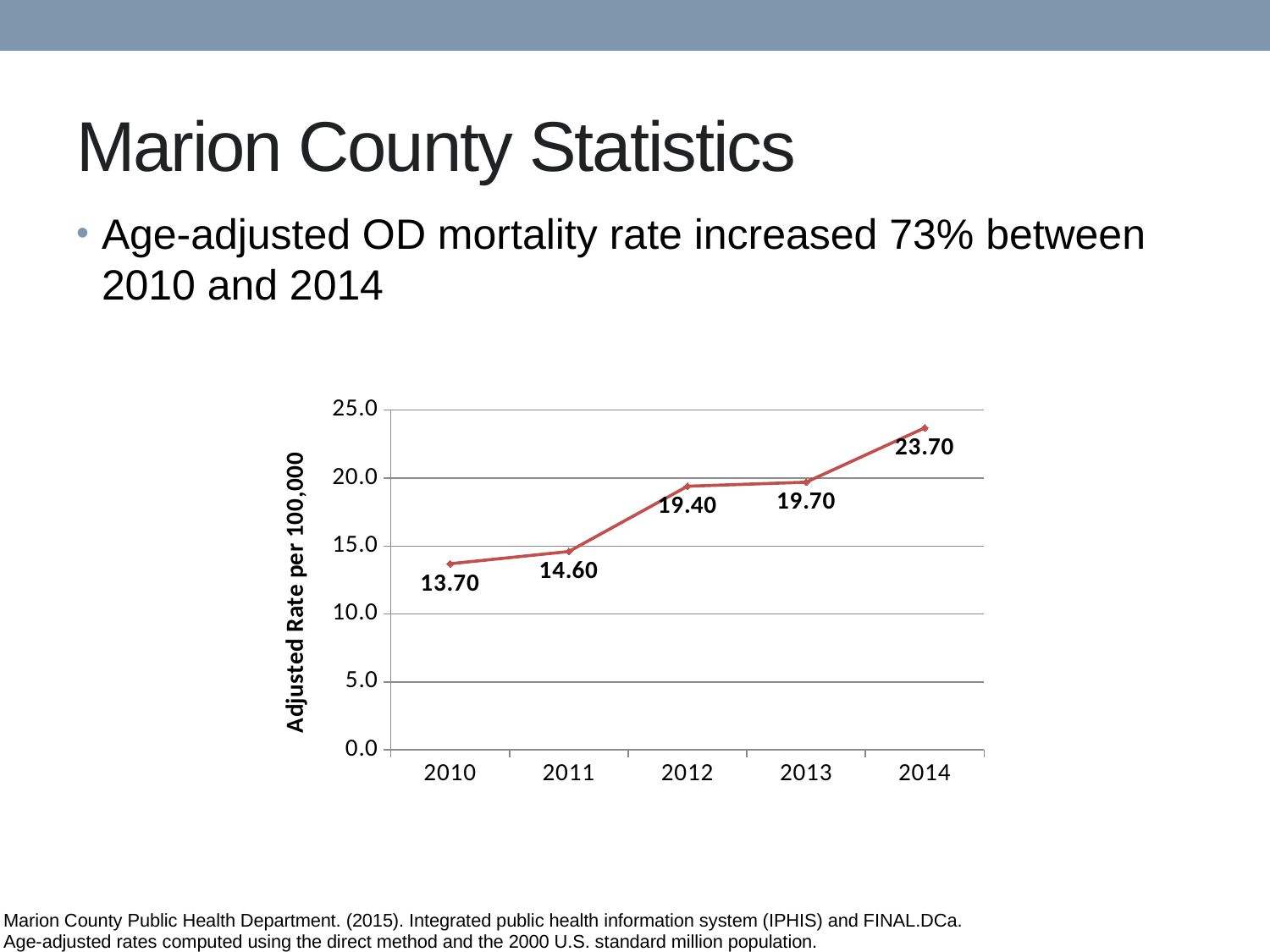
Which year has the lowest adjusted rate? 2010 What is the adjusted rate per 100,000 for 2010? 13.70 What is the adjusted rate per 100,000 for 2012? 19.40 How many years are plotted on the chart? 5 Which year has a larger adjusted rate, 2011 or 2013? 2013 What is the difference between the adjusted rate in 2012 and in 2011? 4.80 What is the difference between the adjusted rate in 2014 and in 2010? 10.00 What is the adjusted rate per 100,000 for 2014? 23.70 Does the adjusted rate rise or fall from 2010 to 2014? rise Which year has the highest adjusted rate? 2014 What kind of chart is shown on the slide? line chart Is the adjusted rate for 2013 greater or less than 15.0? greater